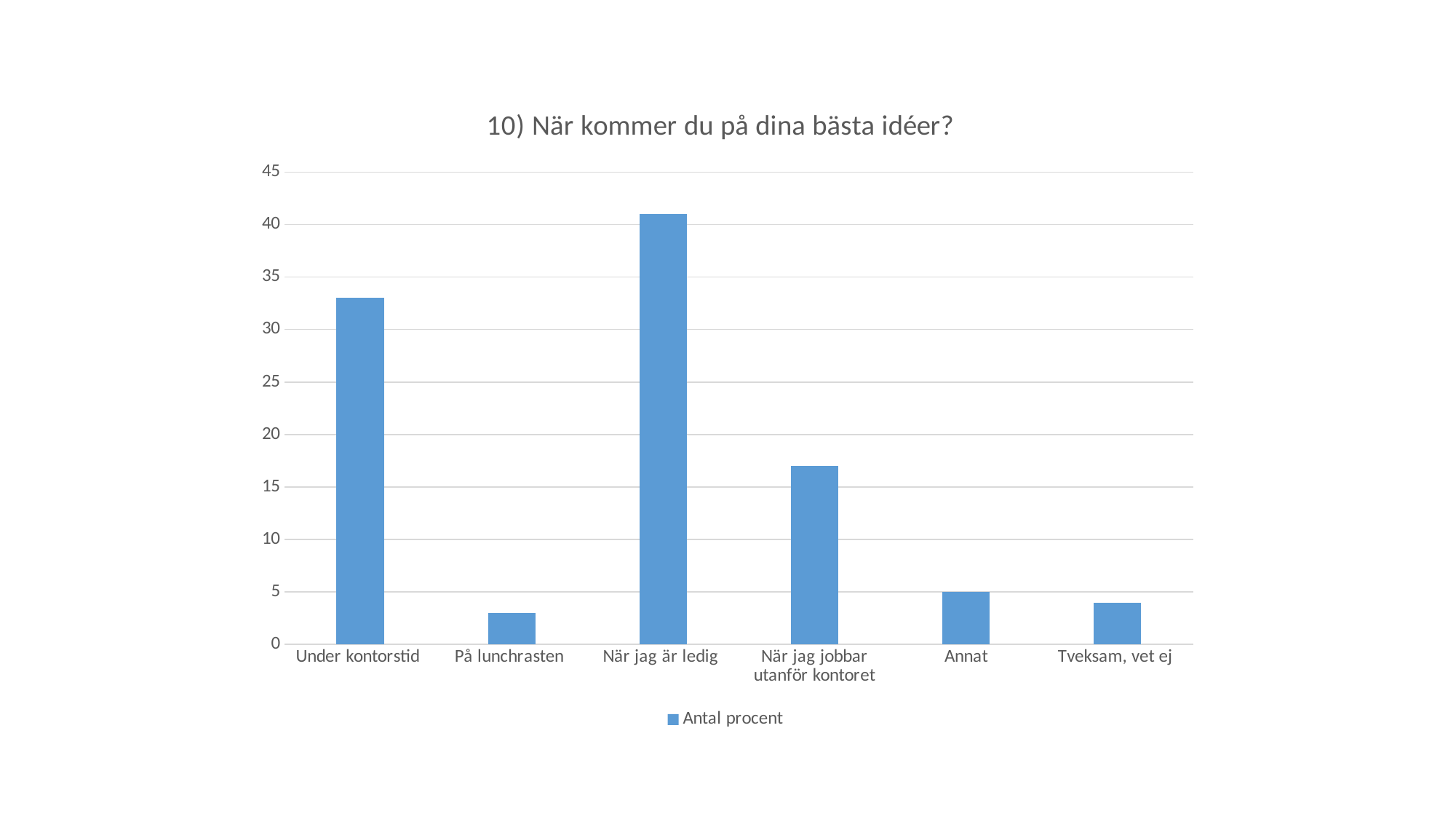
Which category has the highest value? När jag är ledig Is the value for På lunchrasten greater or less than 5? less What kind of chart is shown on the slide? bar chart Which category has the lowest value? På lunchrasten Is the value for När jag jobbar utanför kontoret greater or less than 20? less What is the name of the series shown in the legend? Antal procent Which is larger, the value for Under kontorstid or the value for När jag jobbar utanför kontoret? Under kontorstid How many categories are shown on the x axis? 6 What is the title of the chart? 10) När kommer du på dina bästa idéer? Is the value for Under kontorstid greater or less than 30? greater How many series does the legend list? 1